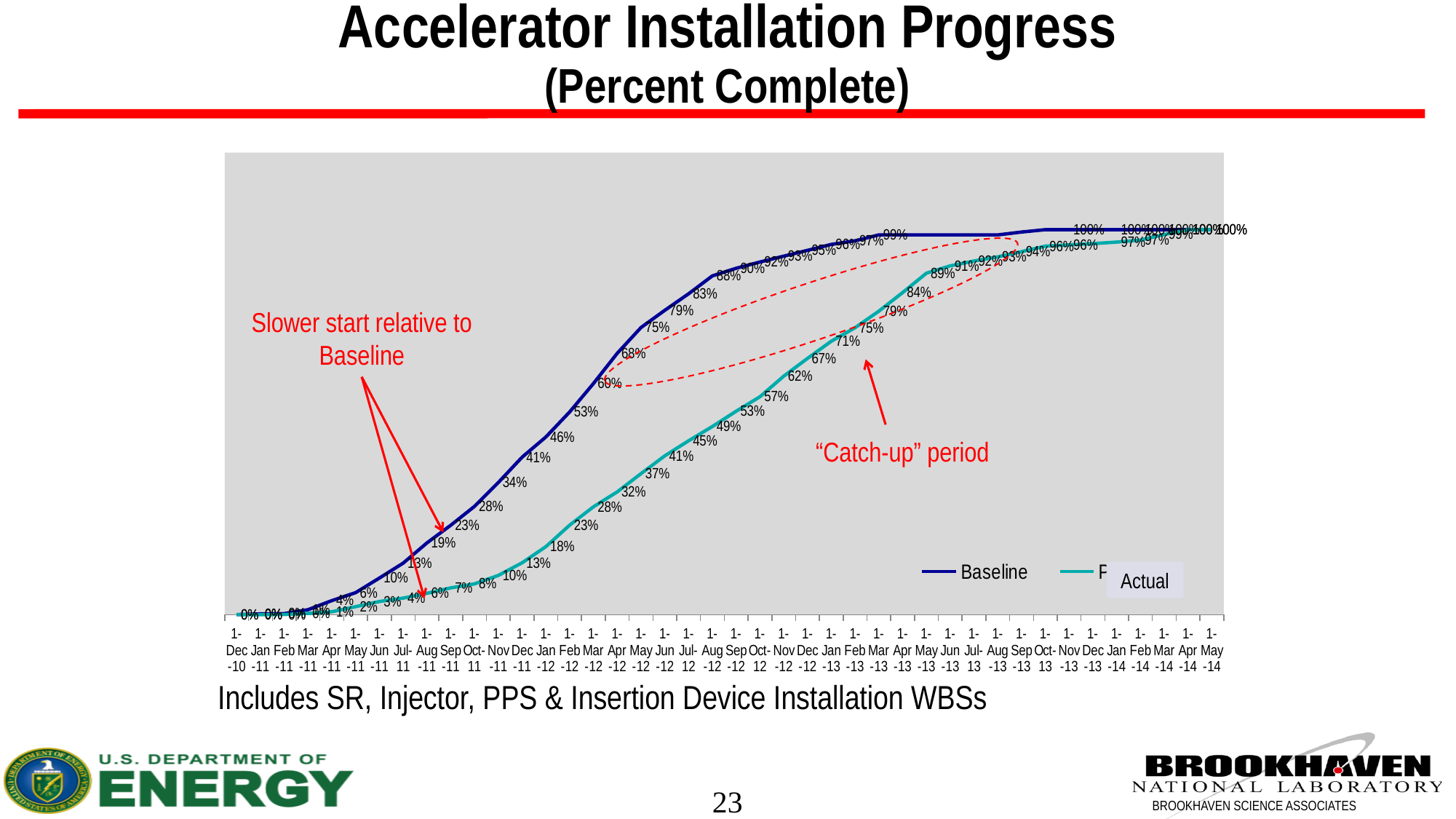
What is the Baseline value at 1-Apr-11? 4% Do the values of the Actual series rise or fall along the x axis? Rise What are the two series named in the legend? Baseline and Actual What is the Baseline value at 1-Dec-10? 0% How many series does the chart's legend list? 2 What is the title of the chart on the slide? Accelerator Installation Progress (Percent Complete) What is the highest value reached by the Baseline series? 100% Which series is higher at 1-Jan-13, Baseline or Actual? Baseline What is the Actual value at 1-Dec-10? 0% How many monthly points are shown on the x axis, from 1-Dec-10 to 1-May-14? 42 Which series is higher at 1-Jun-12, Baseline or Actual? Baseline What kind of chart is shown on the slide? Line chart